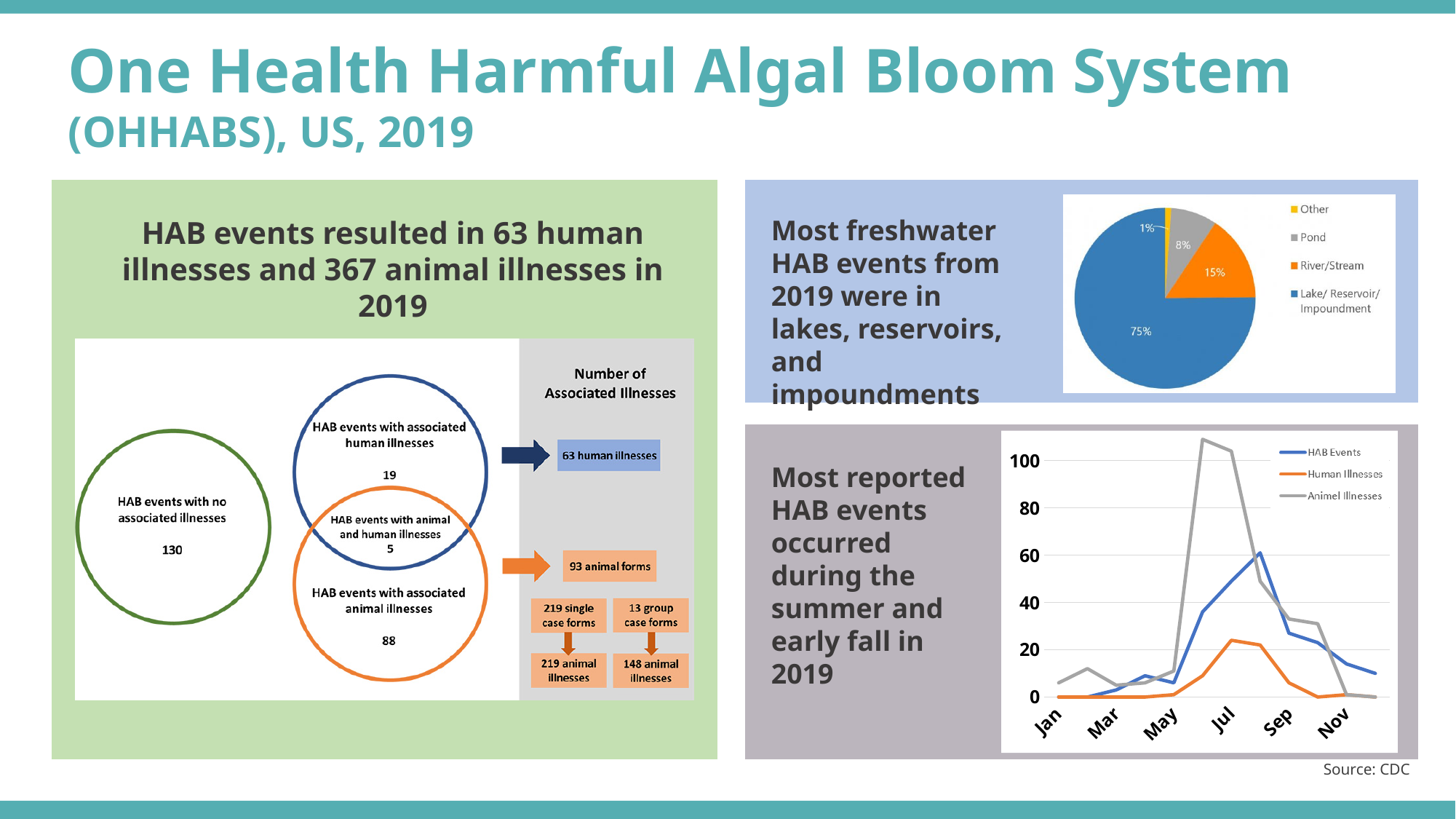
In the pie chart, which category has the smallest slice? Other In the bottom-right line chart, which series reaches the highest peak value? Animal Illnesses In the pie chart, what share of freshwater HAB events occurred in a Pond? 8% In the pie chart, how many percentage points larger is the Lake/ Reservoir/ Impoundment share than the River/Stream share? 60% In the pie chart, what share of freshwater HAB events occurred in a River/Stream? 15% How many categories does the pie chart's legend list? 4 In the pie chart, which category has the largest slice? Lake/ Reservoir/ Impoundment How many series does the legend of the bottom-right line chart list? 3 What kind of chart is the bottom-right chart showing HAB Events, Human Illnesses and Animal Illnesses by month? Line chart In the pie chart, what share of freshwater HAB events occurred in Lake/ Reservoir/ Impoundment? 75% In the bottom-right line chart, is the peak value of Animal Illnesses greater or less than 100? greater In the bottom-right line chart, is the peak value of HAB Events greater or less than 80? less